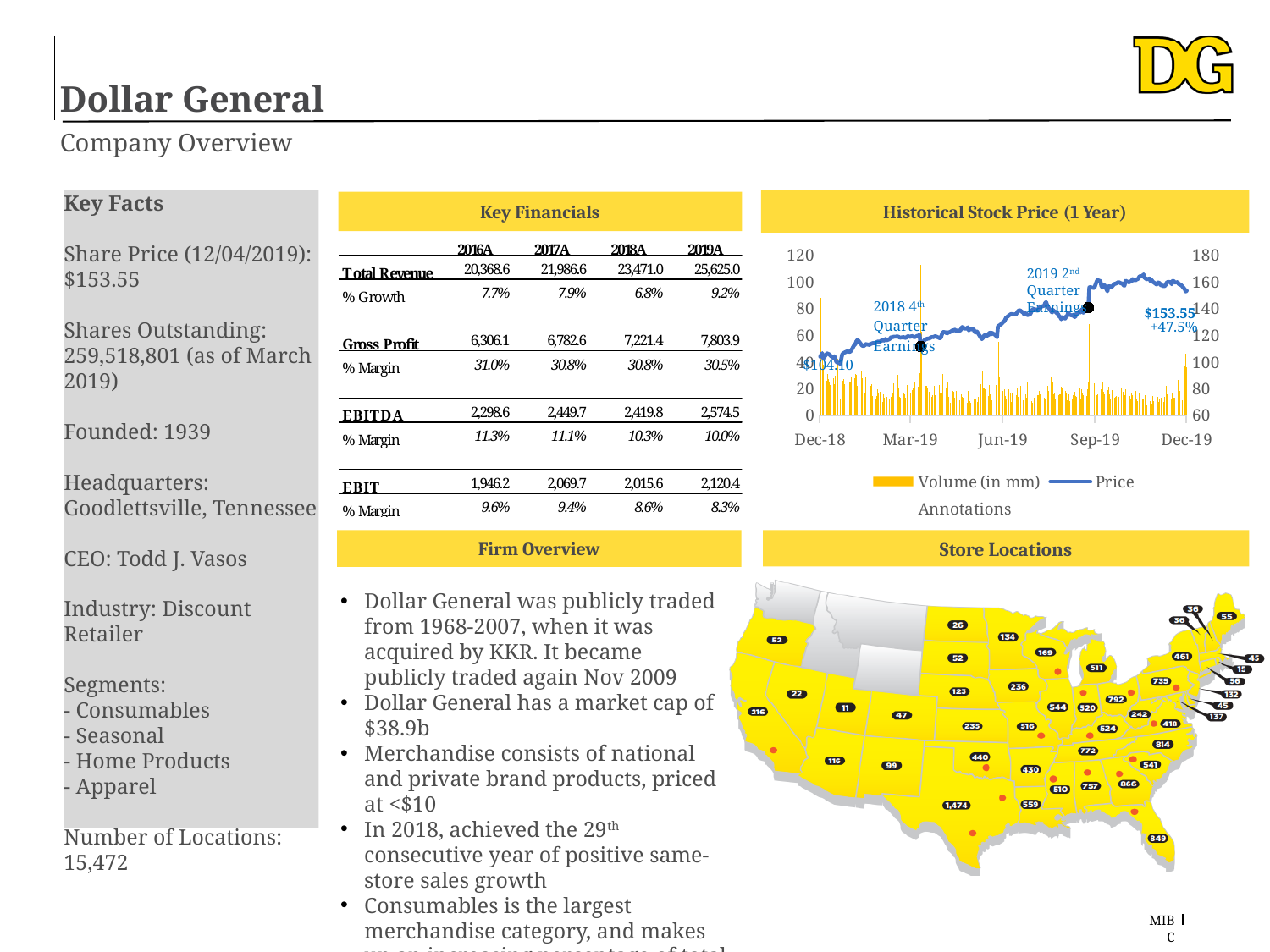
What kind of chart is the Historical Stock Price (1 Year) chart? A combination bar and line chart How many month labels are shown on the x axis of the Historical Stock Price (1 Year) chart? 5 In the Historical Stock Price (1 Year) chart, which series is drawn as yellow bars? Volume (in mm) In the Historical Stock Price (1 Year) chart, what is the share price labelled at the end of the period (Dec-19)? $153.55 In the Historical Stock Price (1 Year) chart, does the price line generally rise or fall from Dec-18 to Dec-19? Rise In the Historical Stock Price (1 Year) chart, what is the share price labelled at the start of the period (Dec-18)? $104.10 How many series does the legend of the Historical Stock Price (1 Year) chart list? 3 In the Historical Stock Price (1 Year) chart, what percentage change is labelled next to the final price? +47.5% In the Historical Stock Price (1 Year) chart, what is the difference between the labelled end price ($153.55) and the labelled start price ($104.10)? $49.45 What is the title of the chart on the right side of the slide? Historical Stock Price (1 Year) In the Historical Stock Price (1 Year) chart, which is larger: the price at Dec-19 or the price at Dec-18? Dec-19 In the Historical Stock Price (1 Year) chart, is the price at Dec-19 greater or less than 140 on the right-hand axis? greater